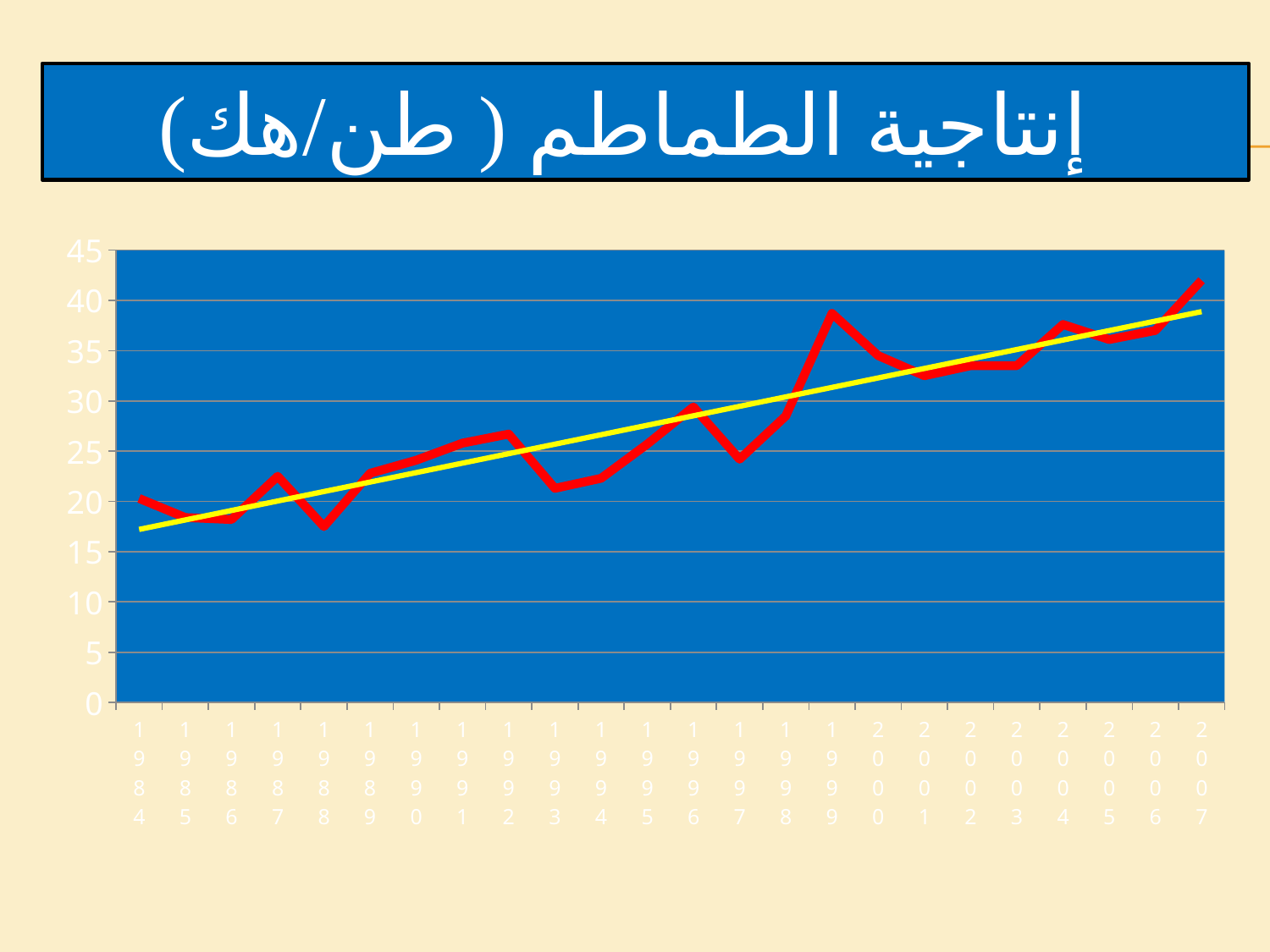
Is the value for 1993 greater or less than 25? less Is the value for 1988 greater or less than 20? less Is the value for 1999 greater or less than 35? greater What is the first year shown on the x axis? 1984 Do the values of the red line generally rise or fall from 1984 to 2007? rise What is the last year shown on the x axis? 2007 Which year has the highest value on the red line? 2007 How many years are plotted along the x axis? 24 Which year has the larger value, 1997 or 1999? 1999 What kind of chart is shown on the slide? line chart What colour is the straight trend line drawn across the chart? yellow